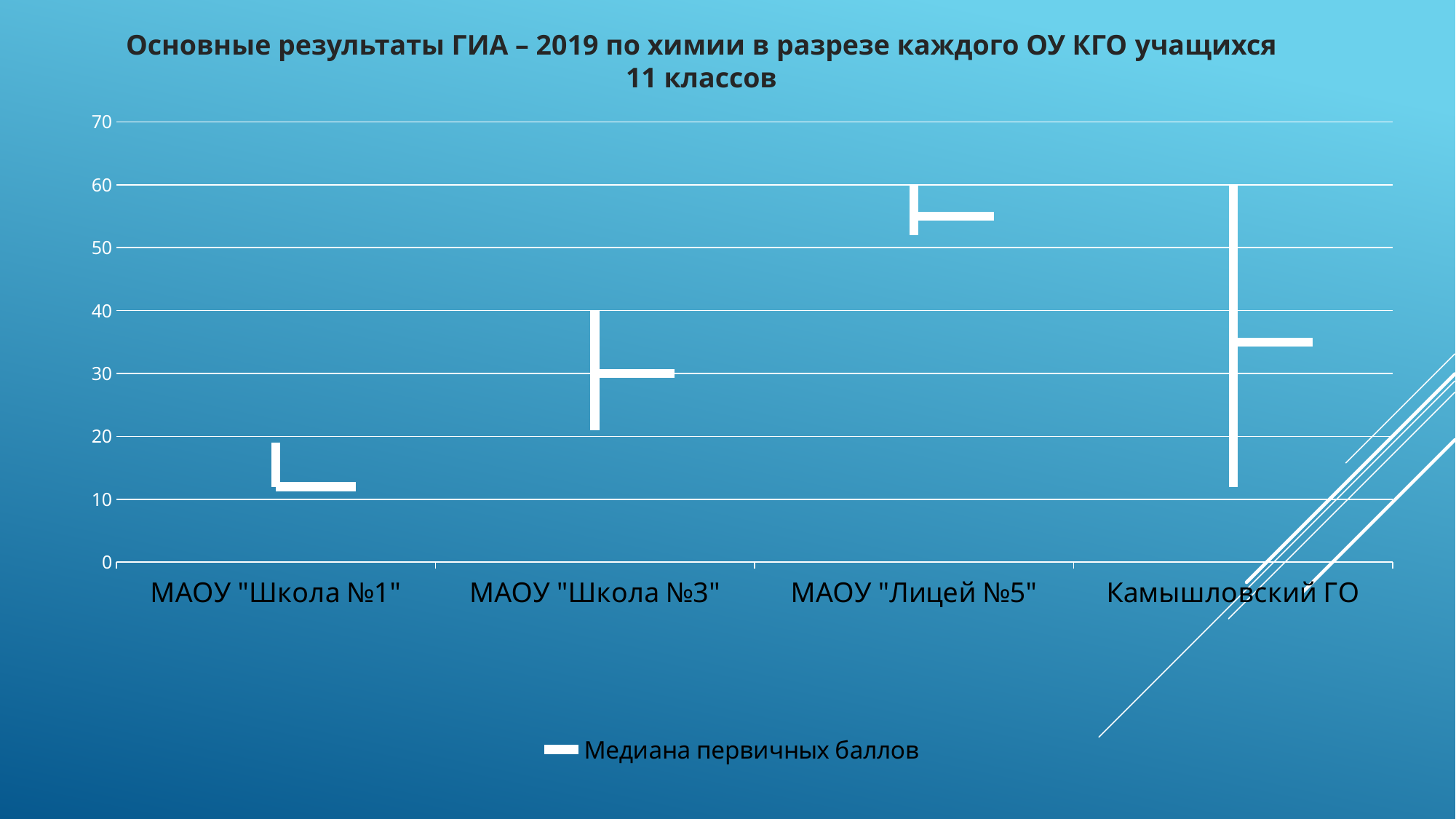
How many series does the legend list? 1 Which has the larger median value, Камышловский ГО or МАОУ "Школа №1"? Камышловский ГО How many categories are shown on the x axis of the chart? 4 Is the median value for Камышловский ГО greater or less than 40? less Is the median value for МАОУ "Школа №1" greater or less than 20? less Which category has the lowest median marker? МАОУ "Школа №1" Is the median value for МАОУ "Лицей №5" greater or less than 50? greater What is the title of the chart? Основные результаты ГИА – 2019 по химии в разрезе каждого ОУ КГО учащихся 11 классов Which has the larger median value, МАОУ "Лицей №5" or МАОУ "Школа №3"? МАОУ "Лицей №5" Which category has the highest median marker? МАОУ "Лицей №5" What is the legend entry shown below the chart? Медиана первичных баллов